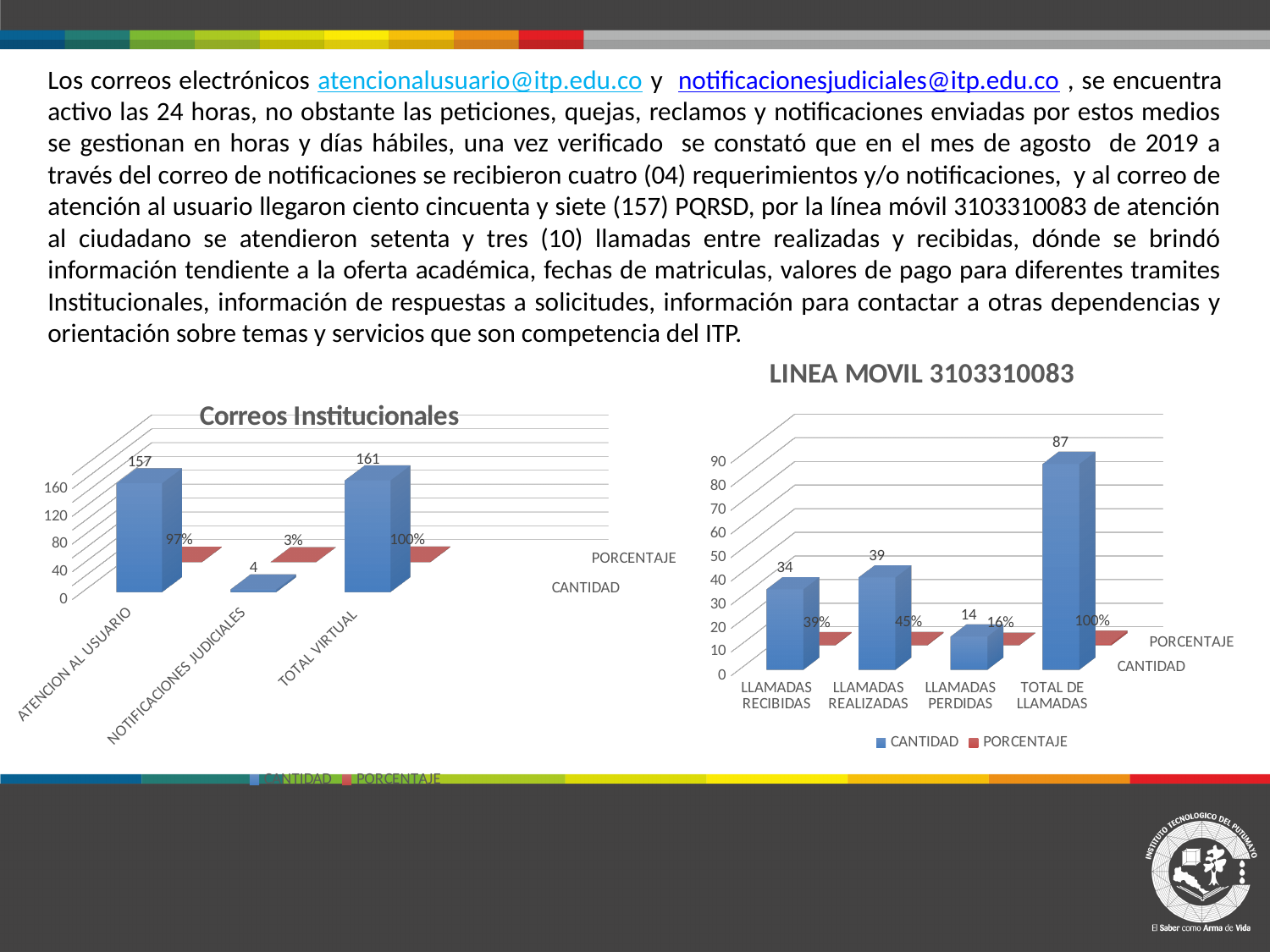
In the 'Correos Institucionales' chart, which category has the lowest CANTIDAD value? NOTIFICACIONES JUDICIALES How many series does the legend of the 'LINEA MOVIL 3103310083' chart list? 2 In the 'Correos Institucionales' chart, what is the CANTIDAD value for TOTAL VIRTUAL? 161 In the 'LINEA MOVIL 3103310083' chart, what is the PORCENTAJE value for LLAMADAS PERDIDAS? 16% How many categories are shown on the x axis of the 'LINEA MOVIL 3103310083' chart? 4 In the 'LINEA MOVIL 3103310083' chart, what is the CANTIDAD value for LLAMADAS REALIZADAS? 39 In the 'Correos Institucionales' chart, what is the CANTIDAD value for ATENCION AL USUARIO? 157 In the 'Correos Institucionales' chart, what is the PORCENTAJE value for NOTIFICACIONES JUDICIALES? 3% In the 'Correos Institucionales' chart, what is the difference in CANTIDAD between ATENCION AL USUARIO and NOTIFICACIONES JUDICIALES? 153 In the 'LINEA MOVIL 3103310083' chart, which has a larger CANTIDAD value, LLAMADAS RECIBIDAS or LLAMADAS REALIZADAS? LLAMADAS REALIZADAS In the 'LINEA MOVIL 3103310083' chart, what is the difference in CANTIDAD between TOTAL DE LLAMADAS and LLAMADAS PERDIDAS? 73 In the 'LINEA MOVIL 3103310083' chart, which category has the highest CANTIDAD value? TOTAL DE LLAMADAS